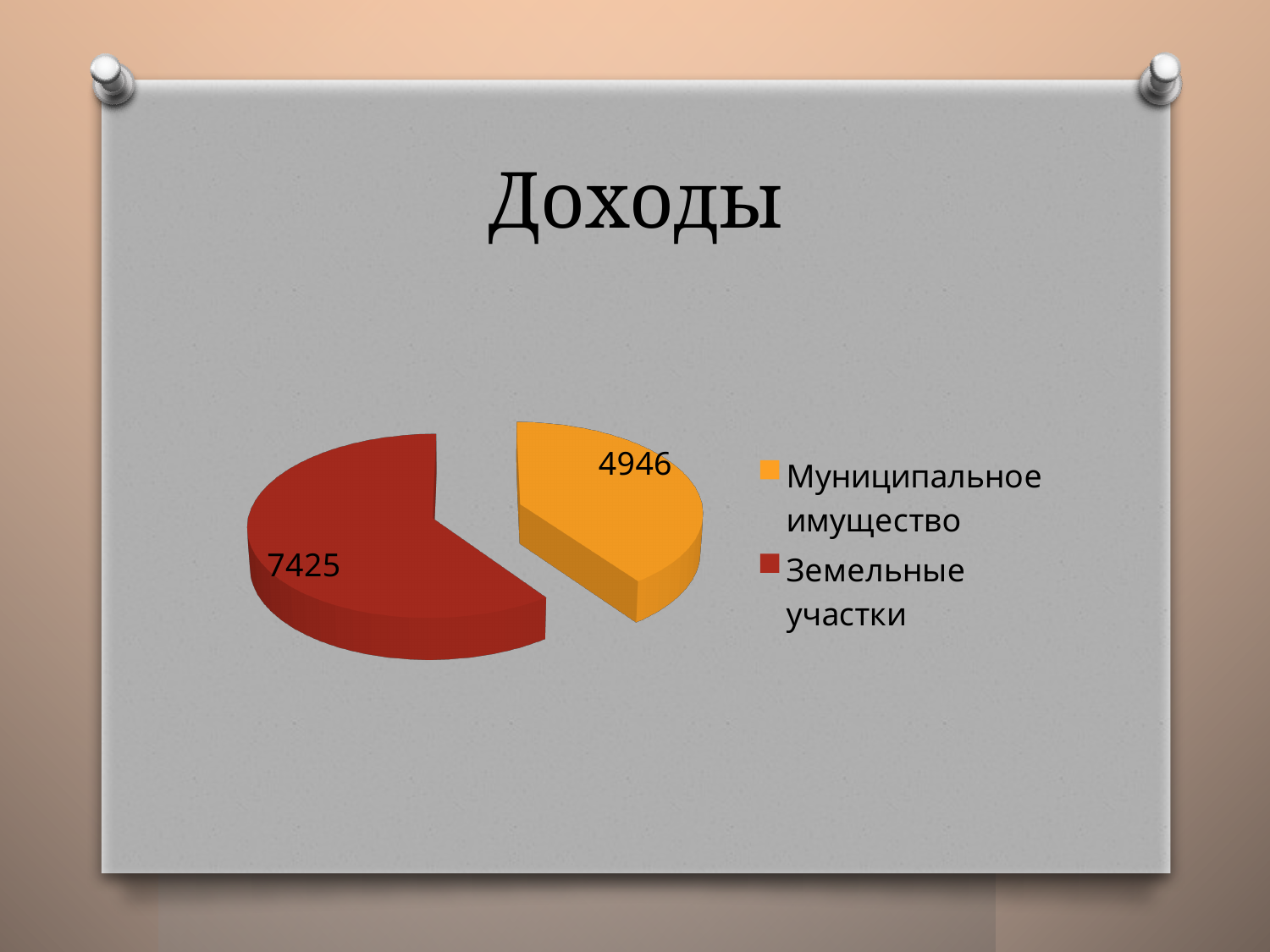
What is the total of the two values shown in the pie chart? 12371 What is the value for Муниципальное имущество? 4946 How many entries does the legend list? 2 What colour is the slice for Земельные участки? Red Which category has the smallest slice of the pie? Муниципальное имущество Which category has the largest slice of the pie? Земельные участки What is the value for Земельные участки? 7425 Which is larger, the value for Муниципальное имущество or the value for Земельные участки? Земельные участки What is the difference between the values for Земельные участки and Муниципальное имущество? 2479 What is the title of the chart? Доходы What kind of chart is shown on the slide? Pie chart How many slices does the pie chart have? 2